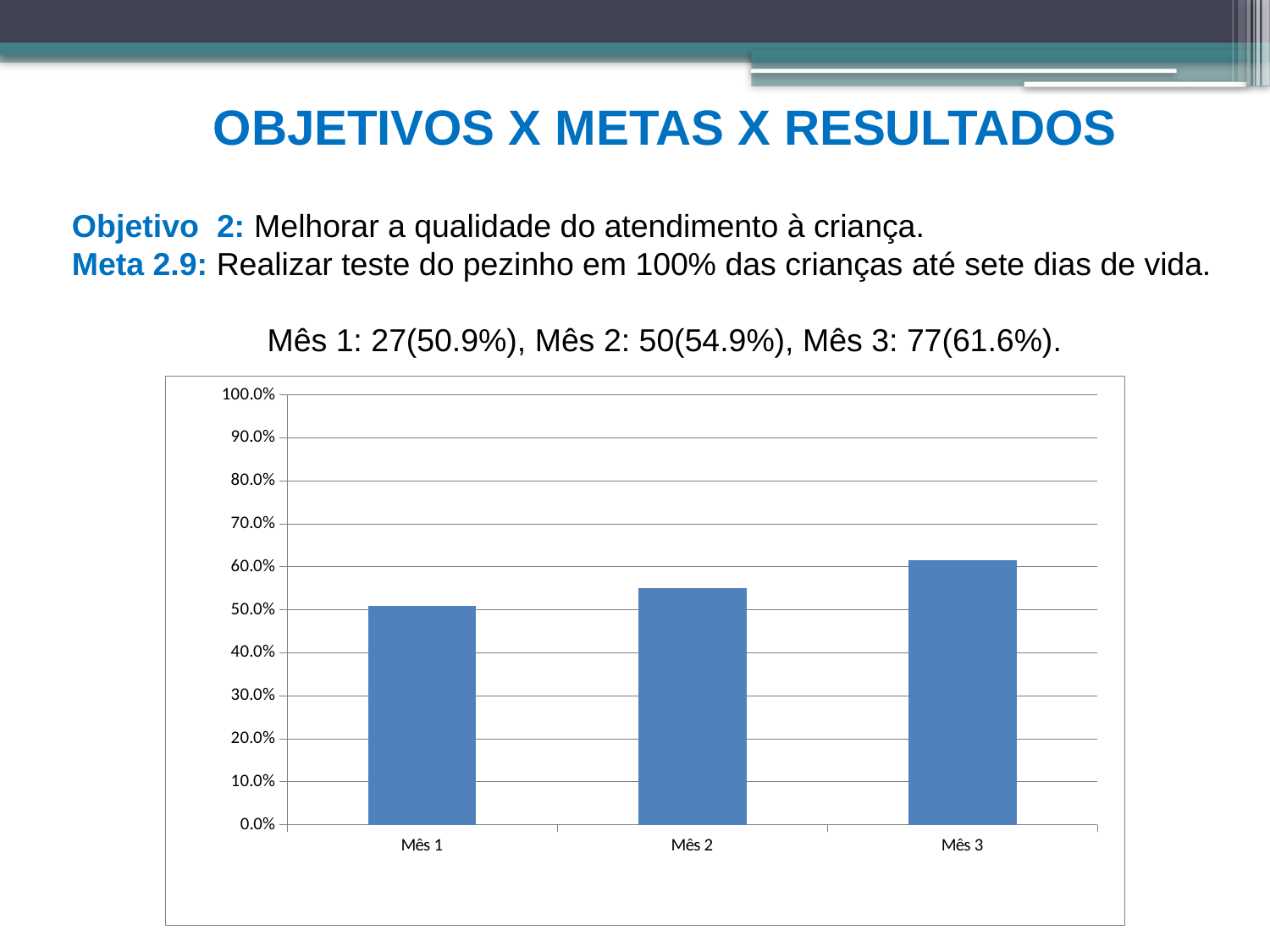
What is the maximum value shown on the vertical axis of the chart? 100.0% What is the value for Mês 3 in the chart? 61.6% Which month has the lowest value in the chart? Mês 1 What is the value for Mês 1 in the chart? 50.9% Is the value for Mês 1 greater or less than 60.0%? less Do the values rise or fall from Mês 1 to Mês 3? Rise What kind of chart is shown on the slide? Bar chart Which is larger, the value for Mês 2 or the value for Mês 3? Mês 3 Which month has the highest value in the chart? Mês 3 Is the value for Mês 3 greater or less than 60.0%? greater How many categories (bars) does the chart show? 3 What is the value for Mês 2 in the chart? 54.9%